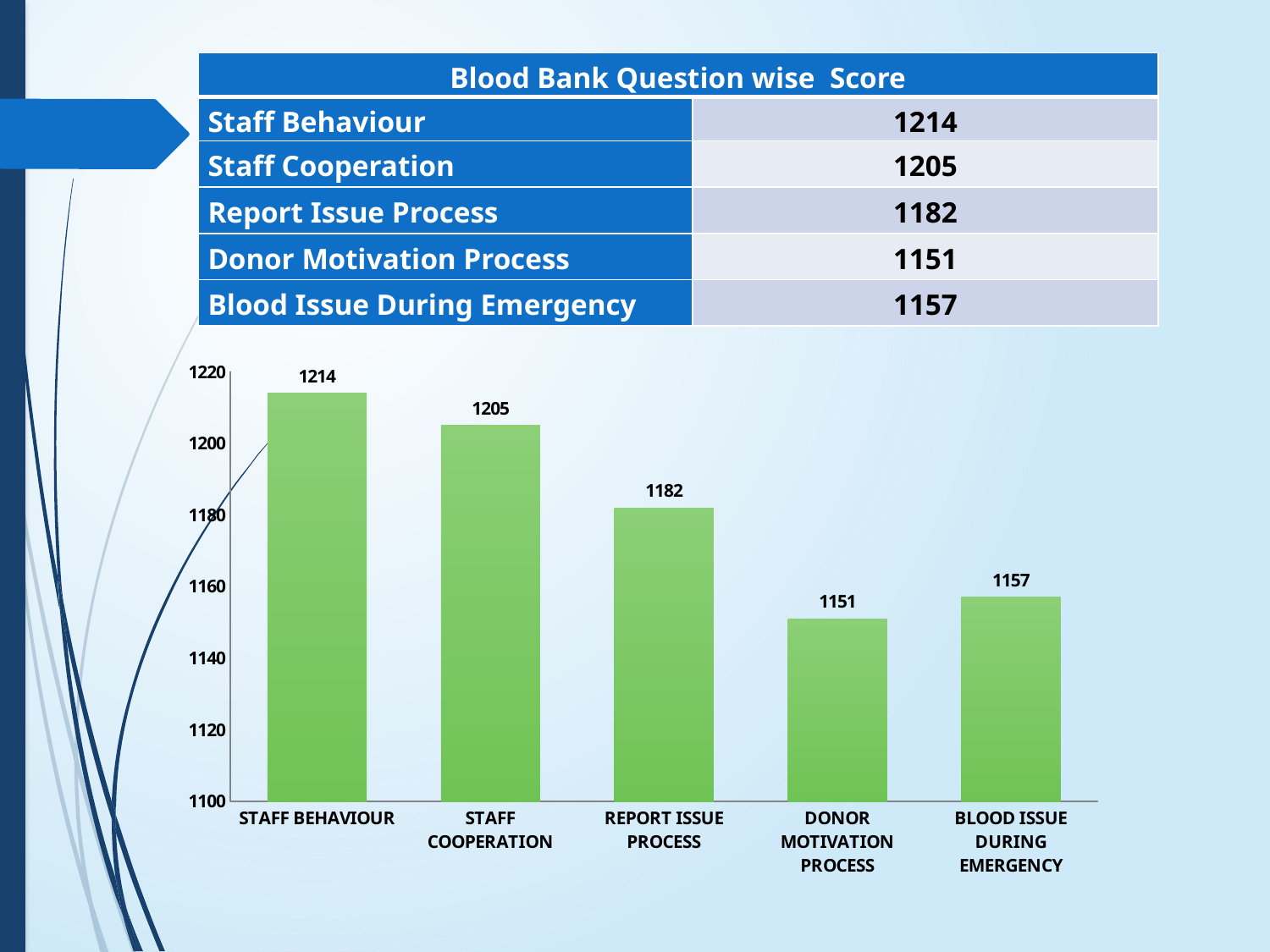
Which is larger, the value for Blood Issue During Emergency or the value for Donor Motivation Process? Blood Issue During Emergency Which category has the highest value? Staff Behaviour What is the difference between the values for Report Issue Process and Donor Motivation Process? 31 What is the value for Blood Issue During Emergency? 1157 What is the value for Staff Behaviour? 1214 Is the value for Report Issue Process greater or less than 1200? less What is the difference between the values for Staff Behaviour and Staff Cooperation? 9 What is the title of the table above the chart? Blood Bank Question wise Score Which category has the lowest value? Donor Motivation Process What kind of chart is shown on the slide? bar chart What is the value for Donor Motivation Process? 1151 How many categories are shown in the chart? 5